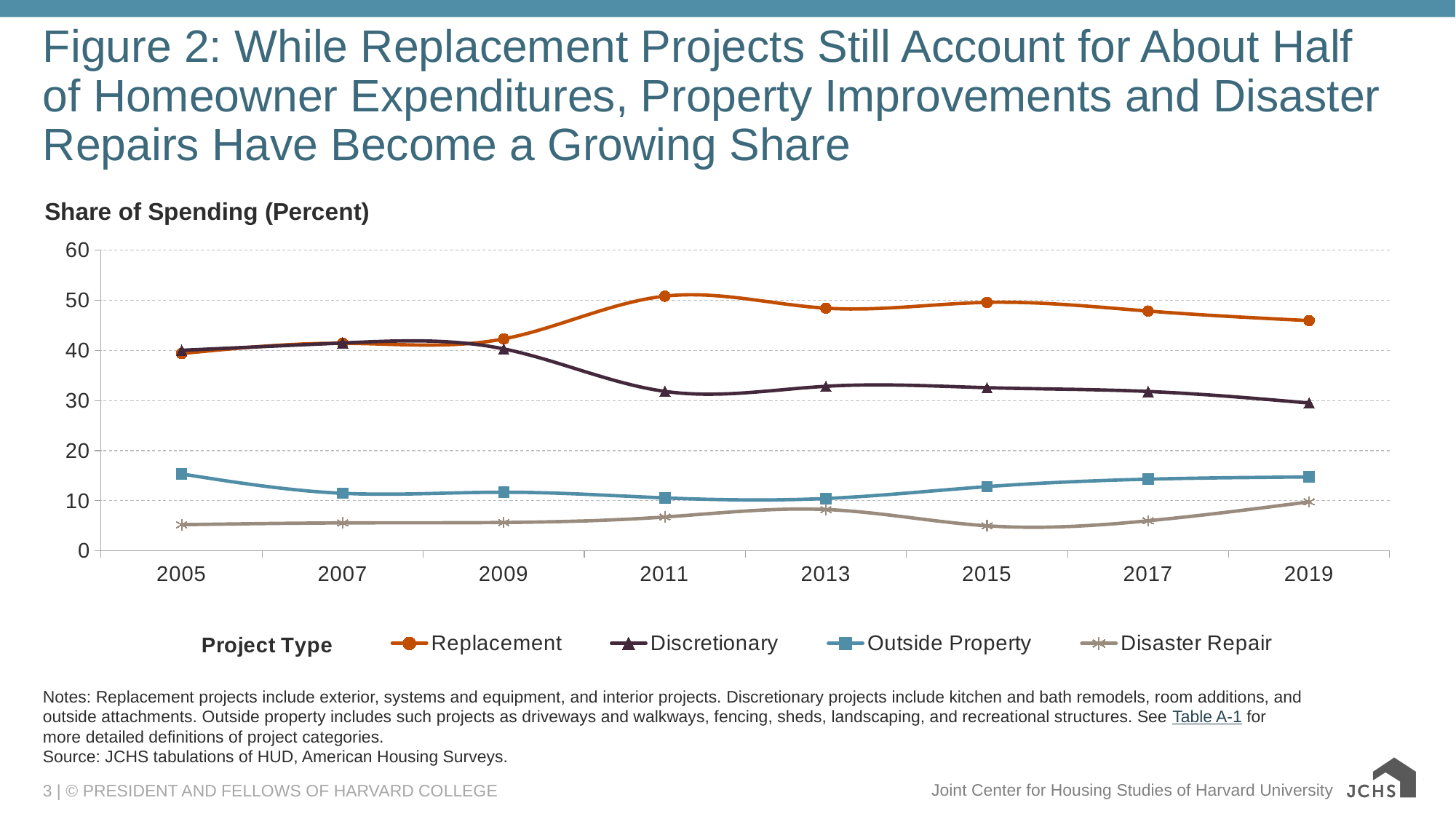
Is the value for Replacement in 2011 greater or less than 40? greater Is the value for Outside Property in 2005 greater or less than 10? greater What is the label of the vertical axis shown above the chart? Share of Spending (Percent) Is the value for Disaster Repair in 2005 greater or less than 10? less What kind of chart is shown on the slide? Line chart In which year does the Replacement series reach its highest value? 2011 Which project type has the lowest share of spending in 2005? Disaster Repair Which is larger in 2013, the share for Replacement or the share for Discretionary? Replacement How many series does the legend list? 4 How many years are plotted along the x axis? 8 Does the Discretionary series rise or fall from 2005 to 2019? Fall Which project type has the highest share of spending in 2019? Replacement